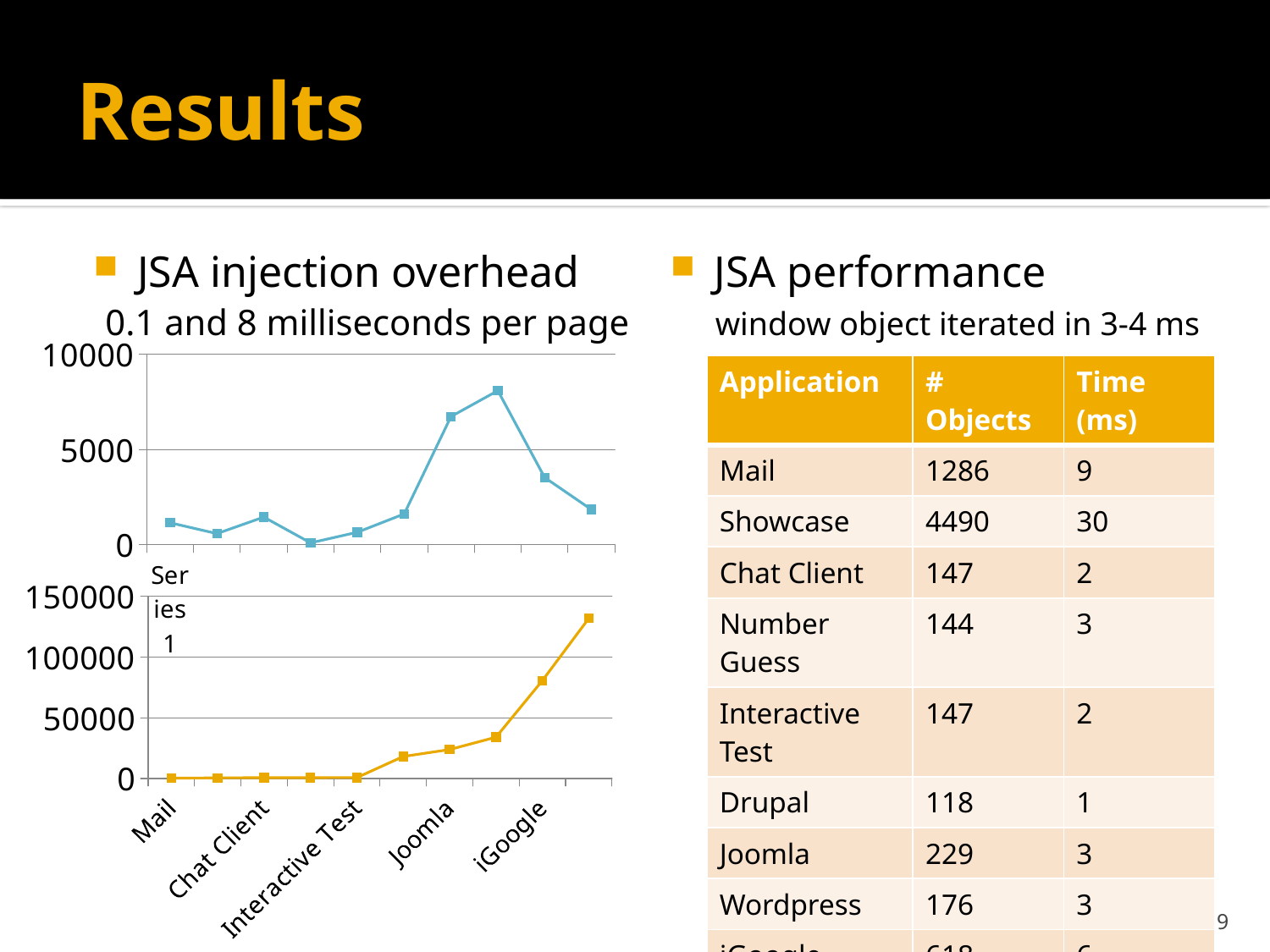
In the bottom chart, which of the labeled categories has the highest value? iGoogle What kind of chart is the bottom chart on the left of the slide? line chart In the bottom chart, do the values generally rise or fall from left to right along the x axis? rise In the bottom chart, is the value for iGoogle greater or less than 50000? greater What is the highest value shown on the vertical axis of the top chart? 10000 How many data points are plotted in the bottom chart? 10 How many data points are plotted in the top chart? 10 In the bottom chart, which has the larger value, Joomla or iGoogle? iGoogle In the bottom chart, is the value for Mail greater or less than 50000? less What kind of chart is the top chart on the left of the slide? line chart In the bottom chart, is the value for iGoogle greater or less than 100000? less